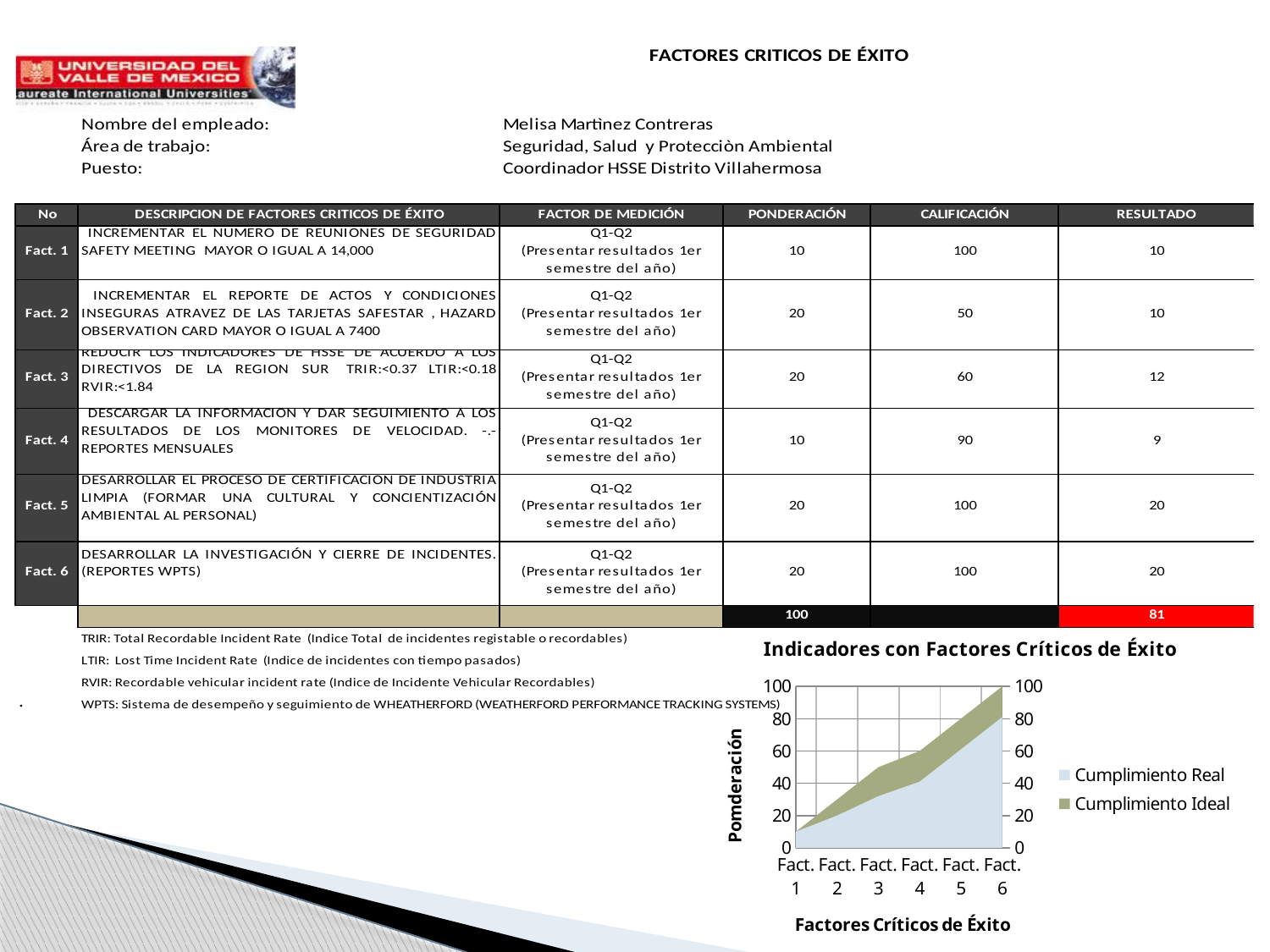
How many series does the chart legend list? 2 What kind of chart is shown on the slide? Area chart Is the value for Cumplimiento Real at Fact. 1 greater or less than 20? less What is the title of the chart on the slide? Indicadores con Factores Críticos de Éxito What are the two series named in the chart legend? Cumplimiento Real and Cumplimiento Ideal Do the plotted values in the chart rise or fall from Fact. 1 to Fact. 6? Rise Is the top of the plotted area at Fact. 6 greater or less than 80? greater Which category has the highest plotted value in the chart? Fact. 6 How many categories are shown along the x axis of the chart? 6 Which category has the lowest plotted value in the chart? Fact. 1 What is the maximum value shown on the chart's y axis? 100